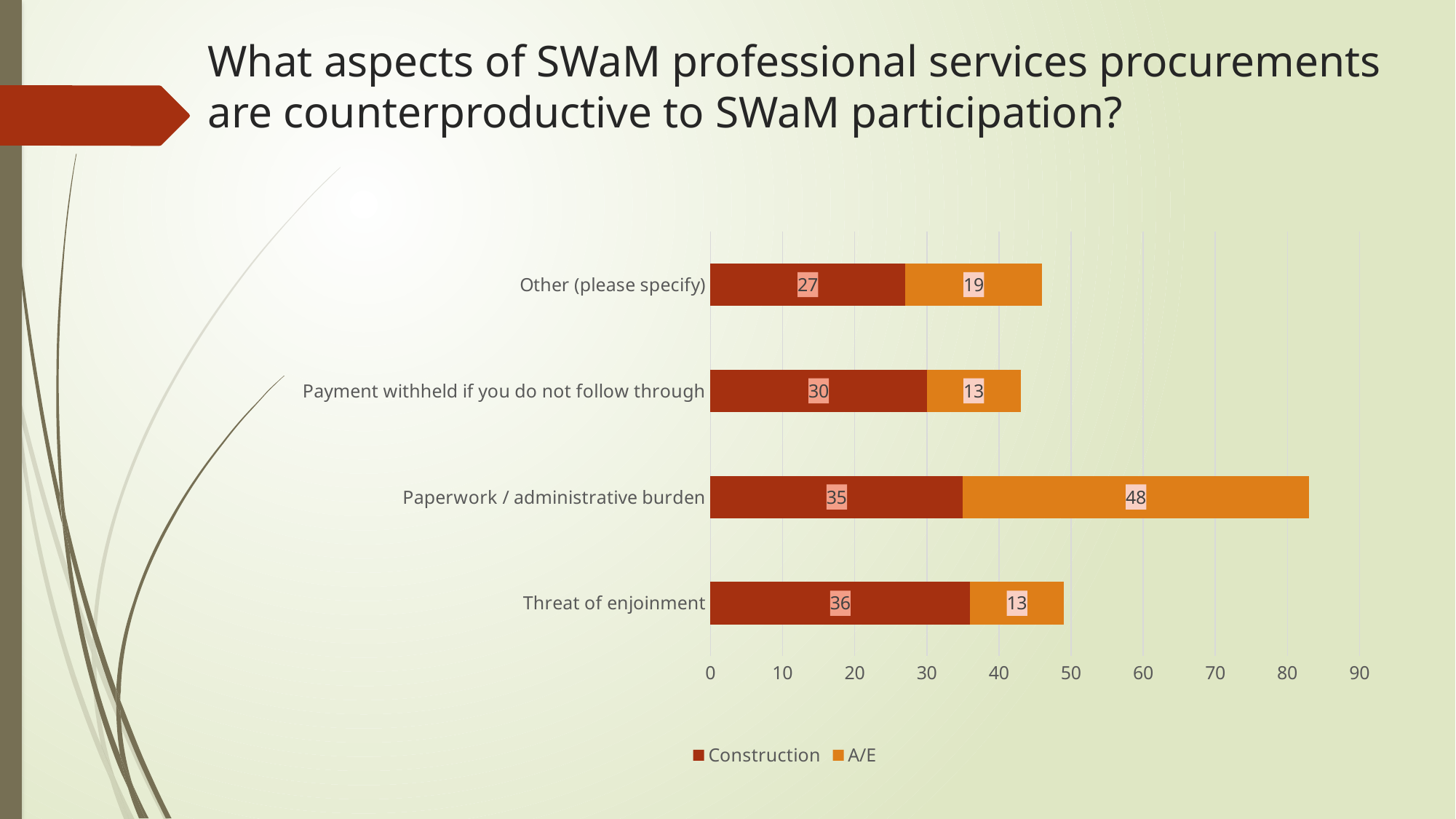
What is the A/E value for Other (please specify)? 19 What is the difference between the A/E value for Paperwork / administrative burden and the A/E value for Threat of enjoinment? 35 What is the total of the stacked bar for Threat of enjoinment? 49 How many categories are shown on the chart? 4 Which category has the highest A/E value? Paperwork / administrative burden What is the Construction value for Paperwork / administrative burden? 35 What is the Construction value for Threat of enjoinment? 36 Which category has the lowest Construction value? Other (please specify) What is the total of the stacked bar for Paperwork / administrative burden? 83 Which is larger: the Construction value for Payment withheld if you do not follow through or the Construction value for Other (please specify)? Payment withheld if you do not follow through How many series does the legend list? 2 What kind of chart is shown on the slide? Stacked bar chart